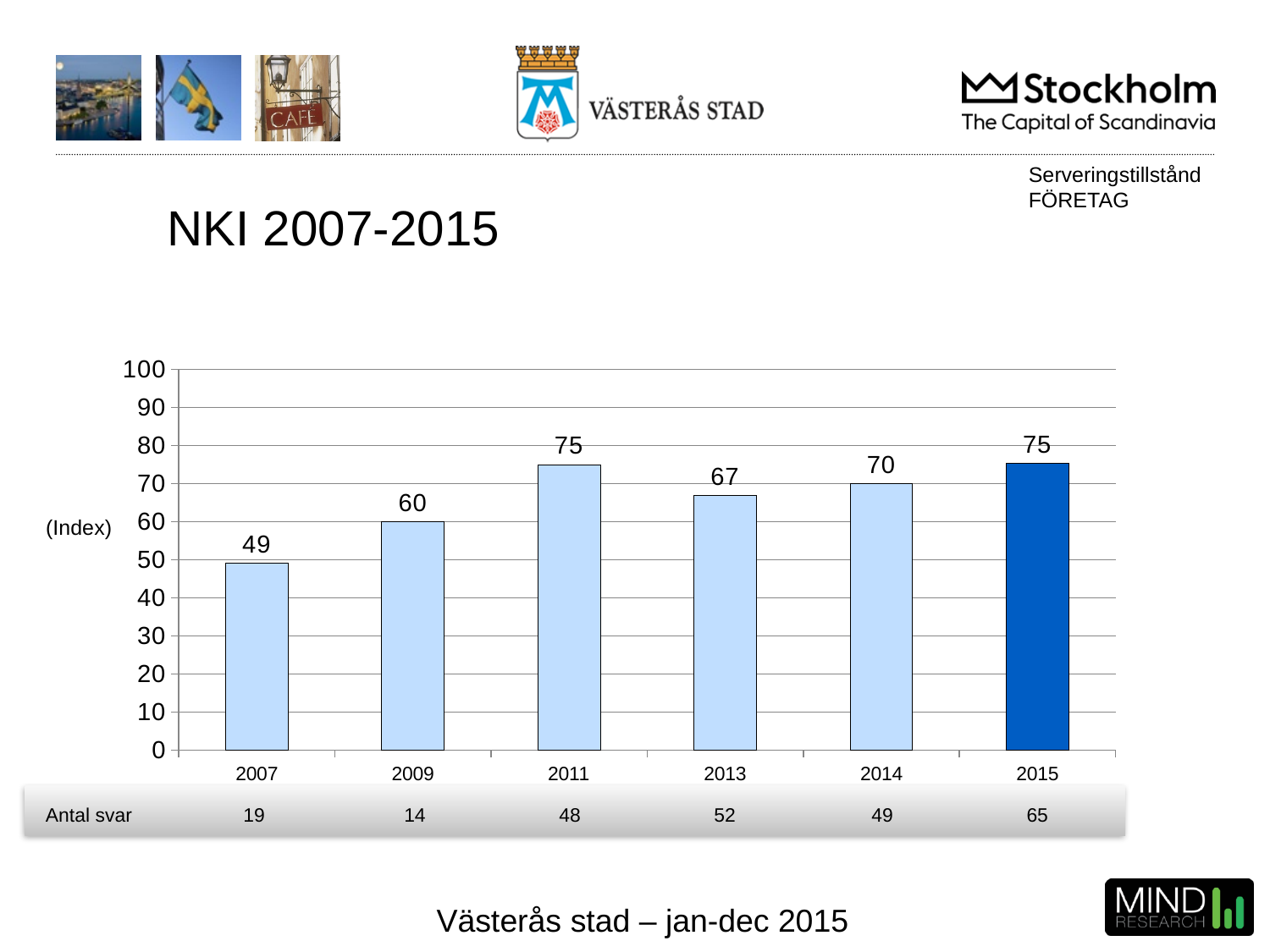
How many years are shown on the x axis of the chart? 6 What is the 'Antal svar' (number of responses) for 2015 shown below the chart? 65 Which year has the lowest NKI index value? 2007 What is the NKI index value for 2007? 49 What is the title of the chart? NKI 2007-2015 What is the difference between the NKI index values for 2015 and 2007? 26 Is the NKI index value for 2009 greater or less than 50? greater Which is larger, the NKI index value for 2009 or for 2014? 2014 What kind of chart is shown on the slide? bar chart What is the difference between the NKI index values for 2011 and 2013? 8 What is the NKI index value for 2014? 70 What is the NKI index value for 2013? 67